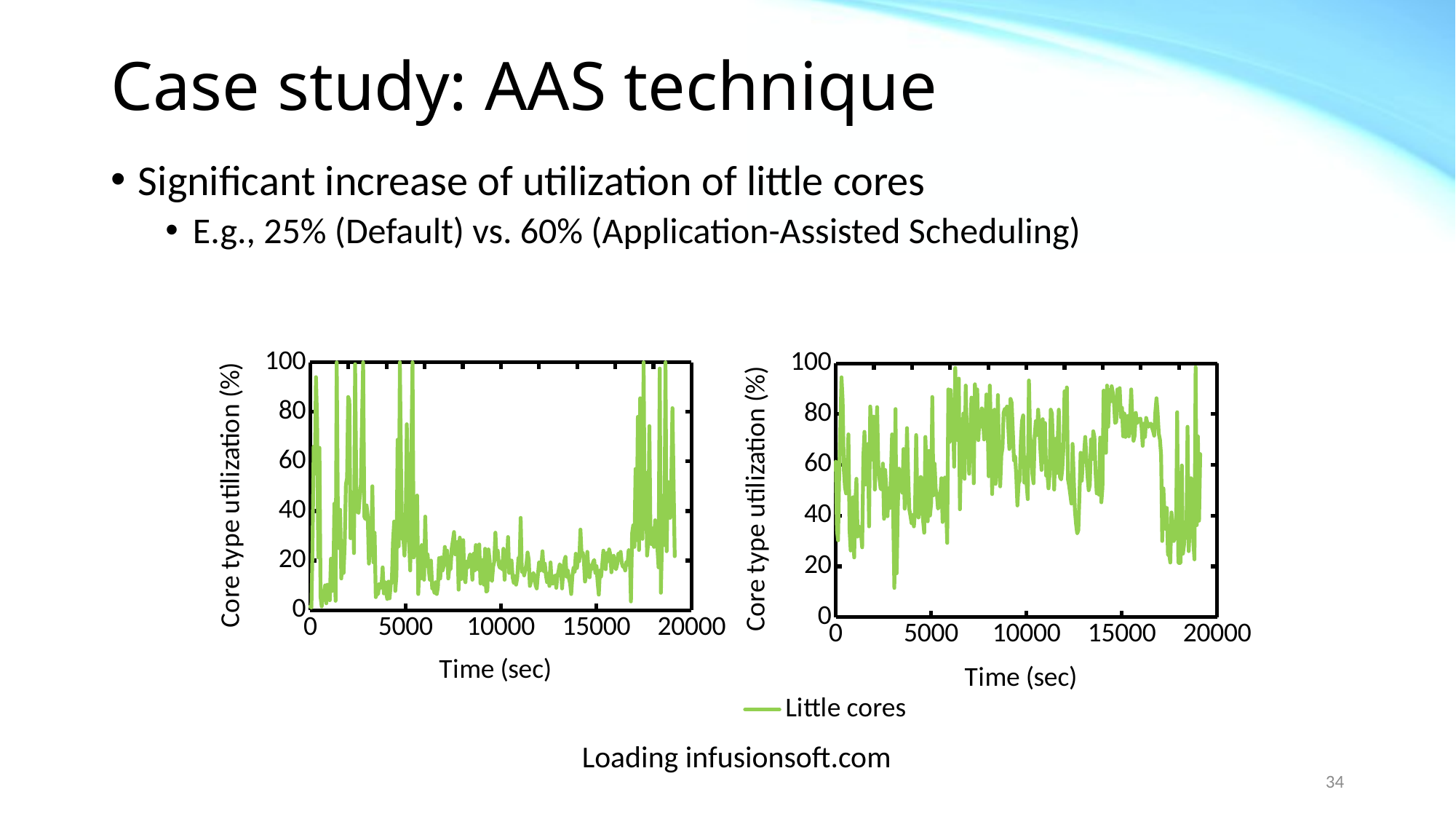
In the left chart, is the value at 10000 sec greater or less than 40? less How many series does the legend below the charts list? 1 In the right chart, is the value at 15000 sec greater or less than 60? greater In the right chart, is the value at 10000 sec greater or less than 40? greater What kind of chart is the right chart on the slide? line chart What kind of chart is the left chart on the slide? line chart What is the name of the series shown in the legend? Little cores What is the maximum value shown on the x axis of the right chart? 20000 What is the y-axis label of the left chart? Core type utilization (%) Which chart shows higher little-core utilization around 10000 sec, the left chart or the right chart? the right chart